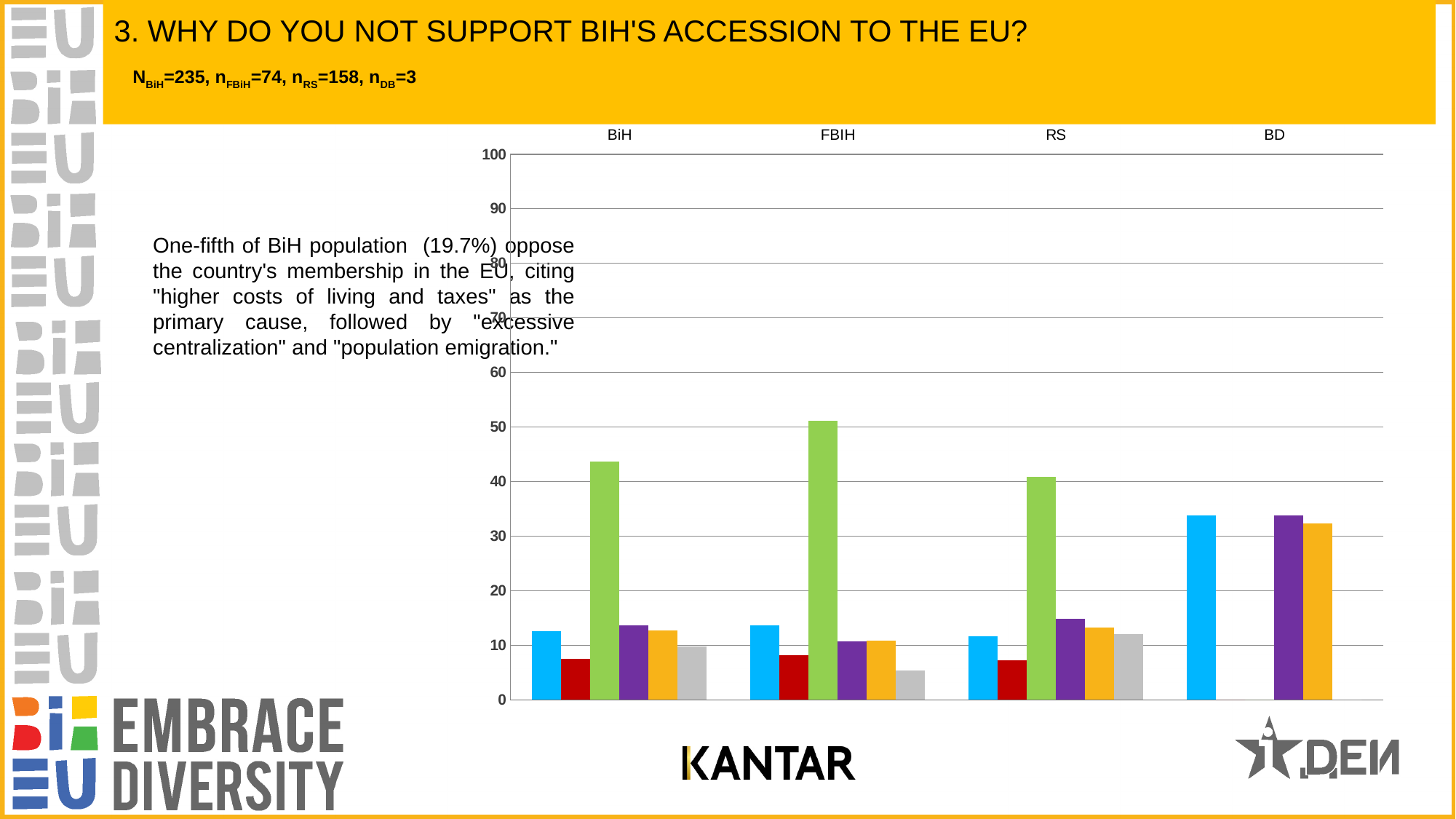
What are the four category labels shown above the chart, from left to right? BiH, FBIH, RS, BD Is the value of the grey bar for FBIH greater or less than 10? less What kind of chart is shown on the slide? bar chart Is the value of the green bar for FBIH greater or less than 40? greater What is the highest value shown on the y axis of the chart? 100 How many categories are shown along the x axis of the chart? 4 How many bars are plotted for the BD category? 3 Is the value of the green bar for BiH greater or less than 40? greater Which is larger, the green bar for FBIH or the green bar for RS? the green bar for FBIH Which category on the x axis contains the tallest bar in the chart? FBIH